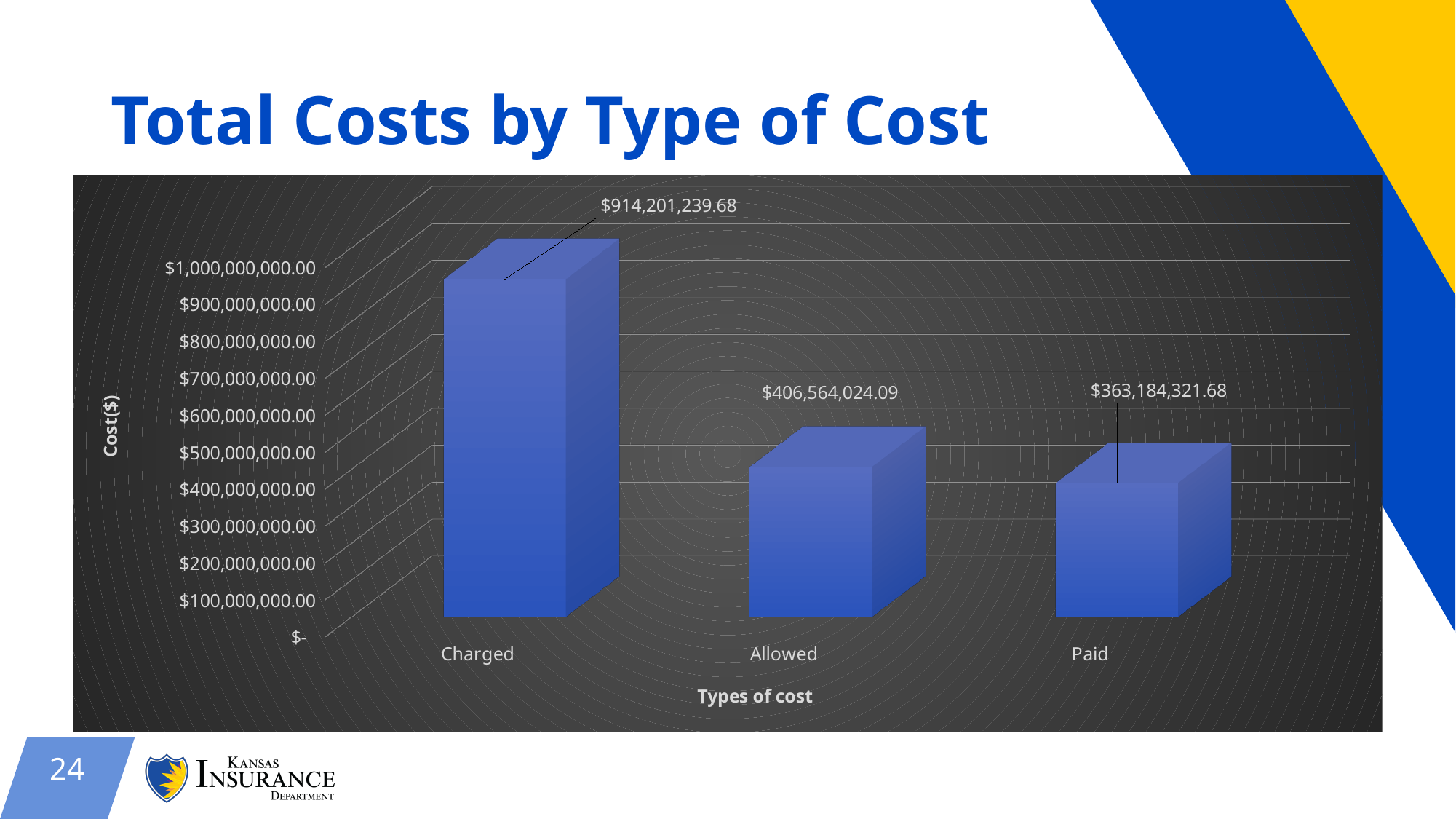
What is the difference between the Charged and Allowed values? $507,637,215.59 Which type of cost has the lowest total cost? Paid What is the value for Allowed? $406,564,024.09 What is the value for Paid? $363,184,321.68 How many types of cost are shown on the chart? 3 Which is larger, the value for Allowed or the value for Paid? Allowed Is the value for Charged greater or less than $900,000,000.00? greater What is the difference between the Allowed and Paid values? $43,379,702.41 What kind of chart is shown on the slide? Bar chart Which type of cost has the highest total cost? Charged What is the label of the vertical axis? Cost($) What is the value for Charged? $914,201,239.68